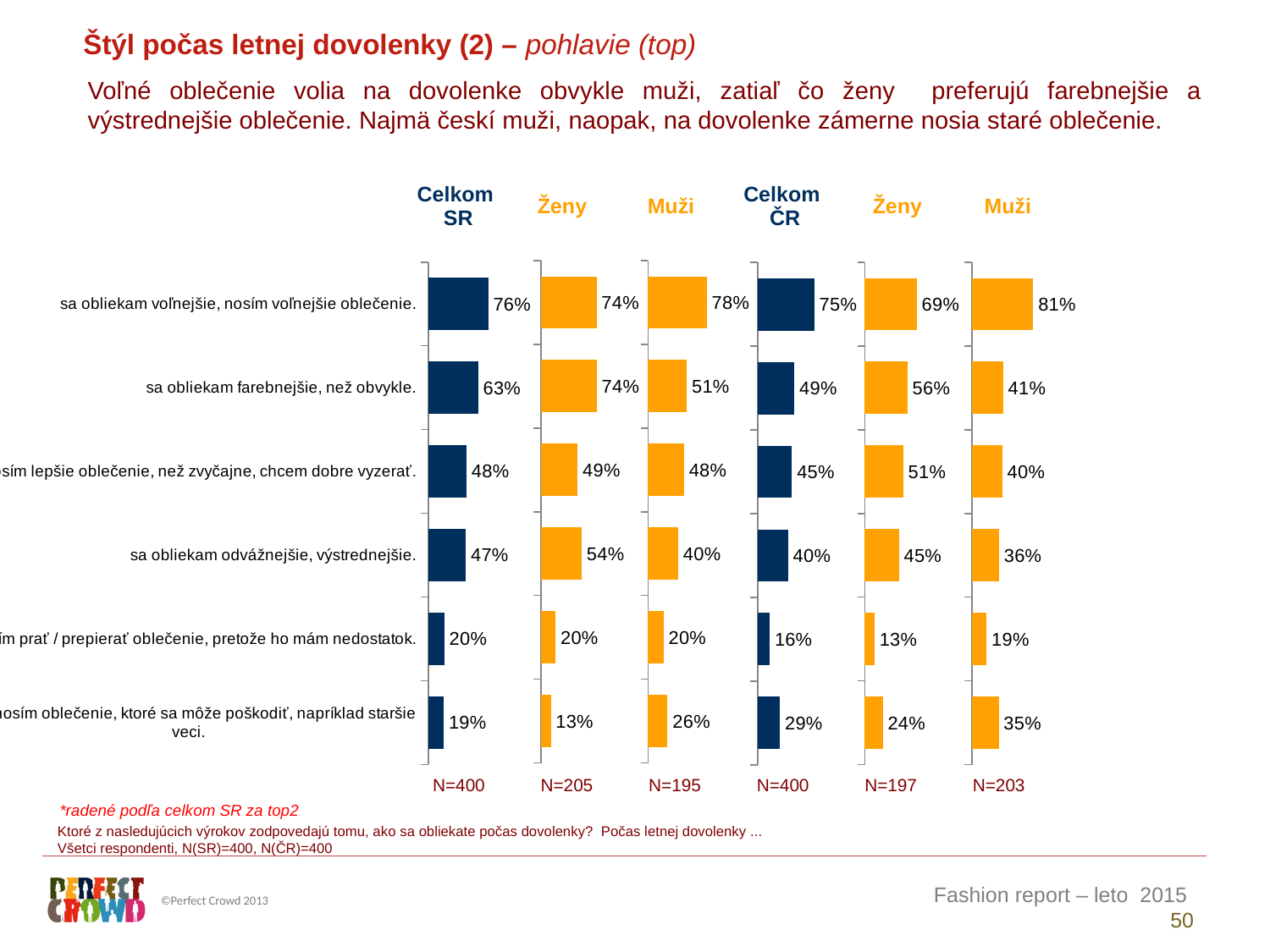
In the Celkom SR chart, which category has the highest value? sa obliekam voľnejšie, nosím voľnejšie oblečenie. For "sa obliekam voľnejšie, nosím voľnejšie oblečenie", which is larger: the Ženy (ČR) value or the Muži (ČR) value? Muži (ČR), 81% In the Muži chart on the far right (ČR), what is the value for "sa obliekam odvážnejšie, výstrednejšie"? 36% How many categories (statements) are plotted in each chart? 6 In the Ženy chart second from the left (SR), what is the value for "sa obliekam farebnejšie, než obvykle"? 74% What type of chart is used on this slide? Bar chart In the Celkom ČR chart, which category has the lowest value? musím prať / prepierať oblečenie, pretože ho mám nedostatok. (16%) What is the difference between the Celkom SR and Celkom ČR values for "sa obliekam farebnejšie, než obvykle"? 14 percentage points How many separate chart columns are shown on the slide? 6 In the Celkom ČR chart, what is the value for "sa obliekam farebnejšie, než obvykle"? 49% In the Celkom SR chart, what is the value for "sa obliekam voľnejšie, nosím voľnejšie oblečenie"? 76% What is the sample size (N) shown under the Celkom ČR chart? N=400